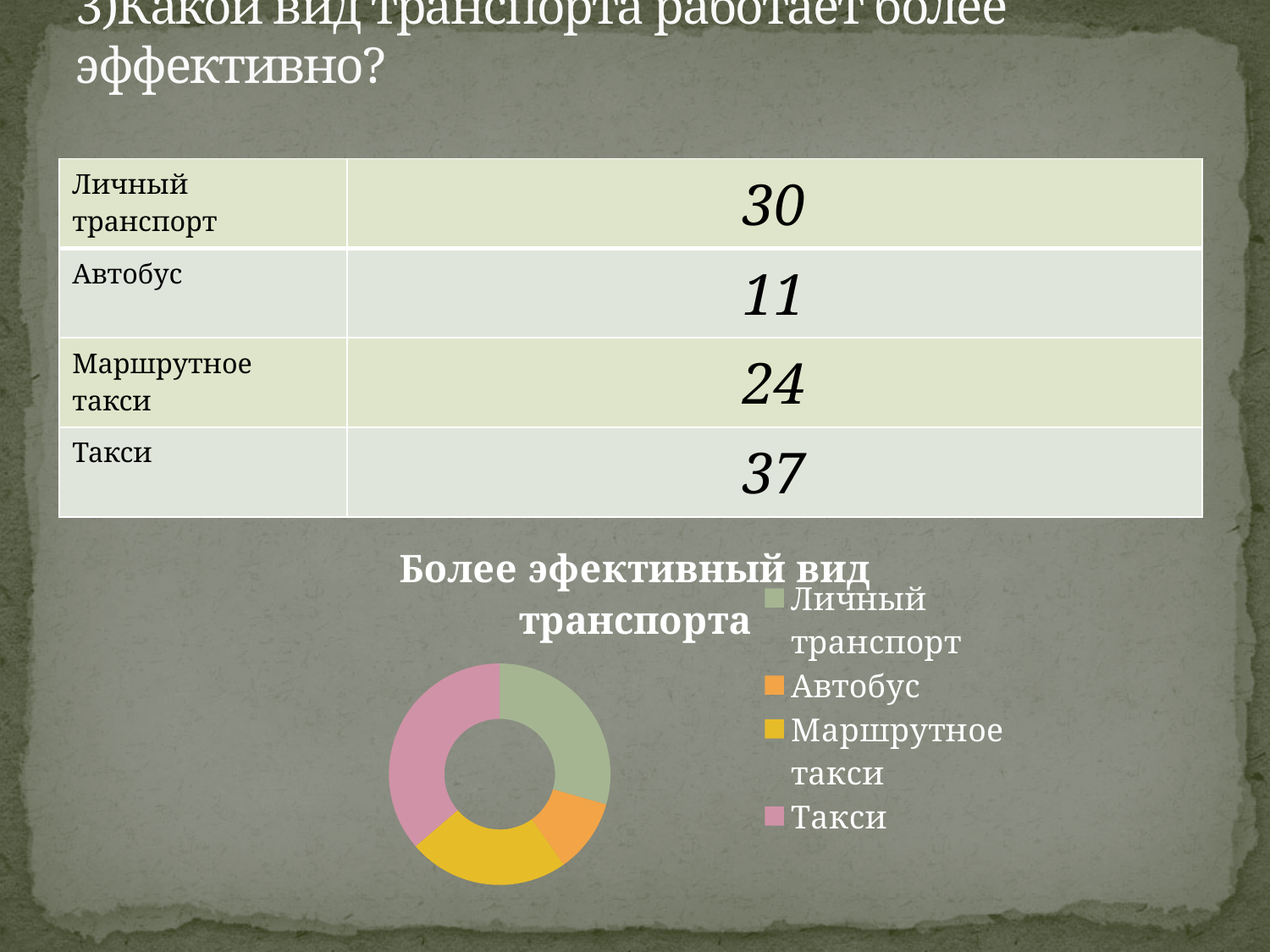
Which category has the smallest value? Автобус What is the value for Такси? 37 What type of chart is shown on the slide? doughnut (pie) chart Which is larger, the value for Личный транспорт or the value for Маршрутное такси? Личный транспорт What is the title of the chart? Более эфективный вид транспорта What is the value for Личный транспорт? 30 How many entries does the chart legend list? 4 How many categories does the chart show? 4 Which category has the largest value? Такси What is the difference between the values for Такси and Автобус? 26 What is the value for Маршрутное такси? 24 What is the value for Автобус? 11